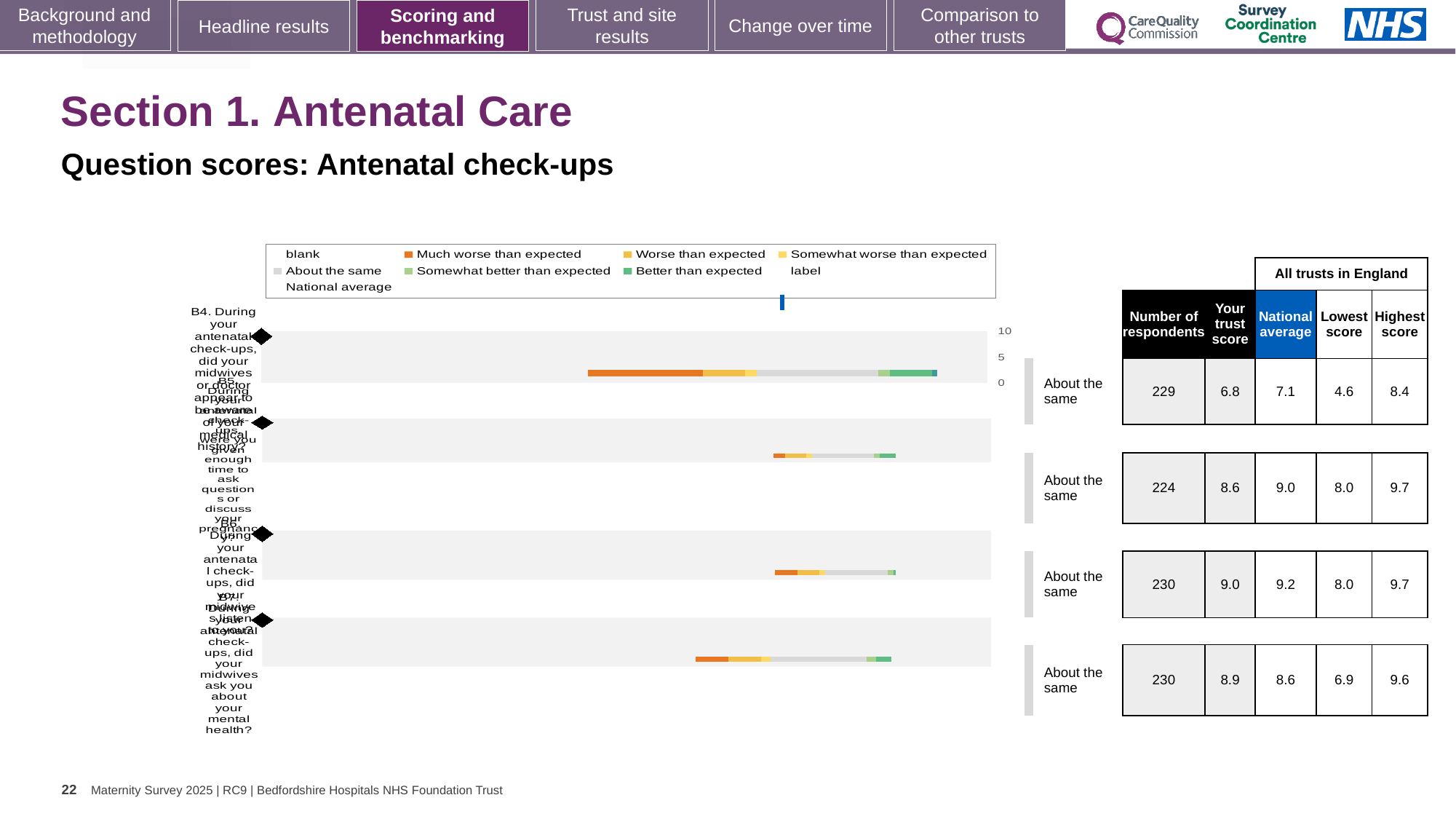
What is the lowest score among all trusts in England for the fourth row (midwives asking about your mental health)? 6.9 For the fourth row (midwives asking about your mental health), which is larger: the trust score or the national average? Trust score (8.9) What benchmark category is shown for all four questions? About the same What is the difference between the national average and the trust score for question B4? 0.3 What is the trust score for question B4 (midwives or doctor appearing aware of your medical history)? 6.8 Which row has the highest trust score? The third row (9.0) What type of chart is shown on the slide? Bar chart Which row has the lowest trust score? B4 (6.8) What is the national average for question B4 (midwives or doctor appearing aware of your medical history)? 7.1 What is the highest score among all trusts in England for question B4? 8.4 What is the number of respondents for question B4 (midwives or doctor appearing aware of your medical history)? 229 How many questions (rows) are plotted in the chart? 4